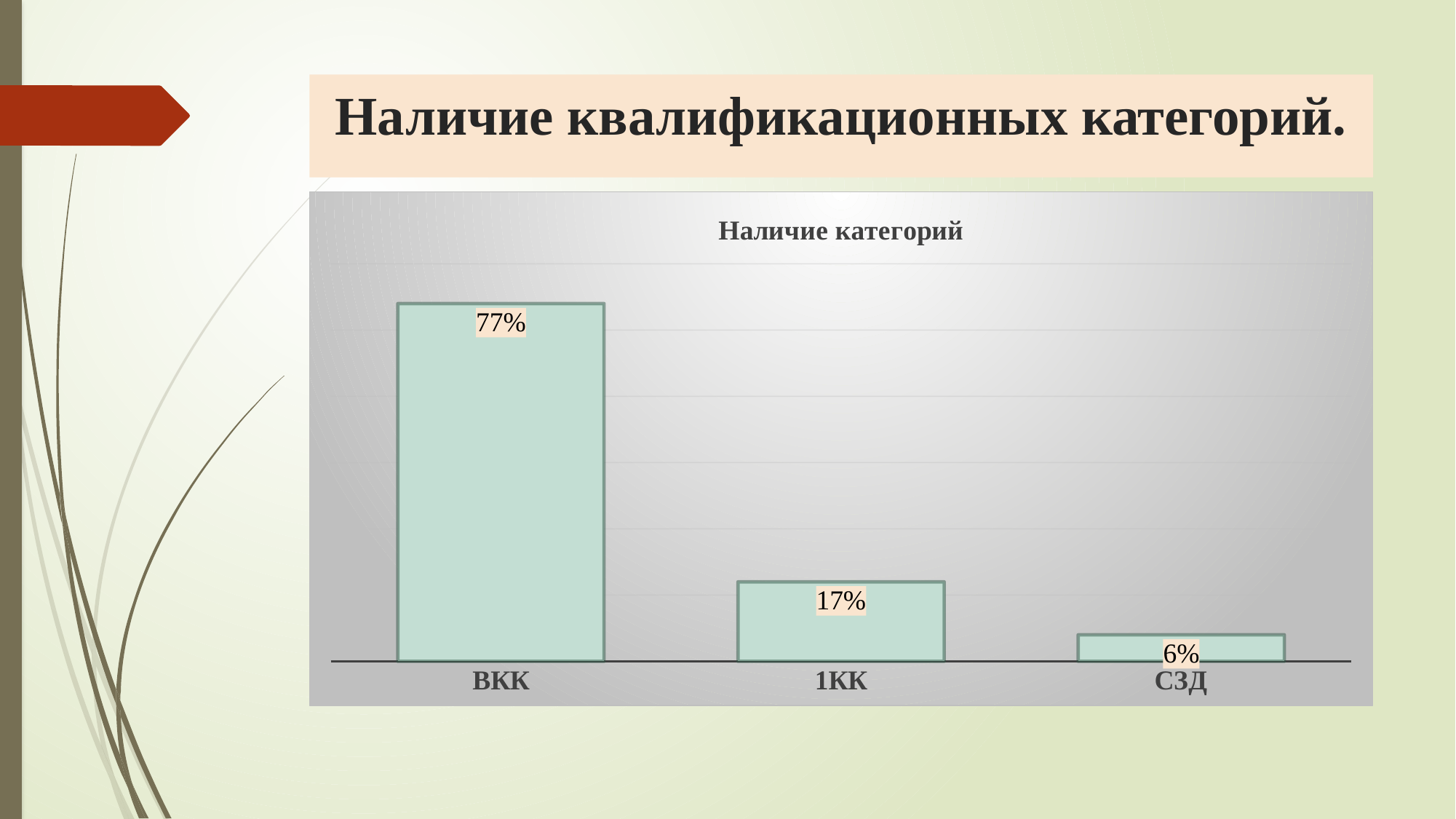
What is the difference between the values for 1КК and СЗД? 11% What is the value for СЗД? 6% What is the difference between the values for ВКК and 1КК? 60% How many categories are shown in the chart? 3 Which category has the lowest value? СЗД Do the values rise or fall from left to right along the x axis? fall Which category has the highest value? ВКК What kind of chart is shown on the slide? bar chart What is the value for ВКК? 77% Which is larger, the value for 1КК or the value for СЗД? 1КК What is the value for 1КК? 17% What is the title of the chart? Наличие категорий